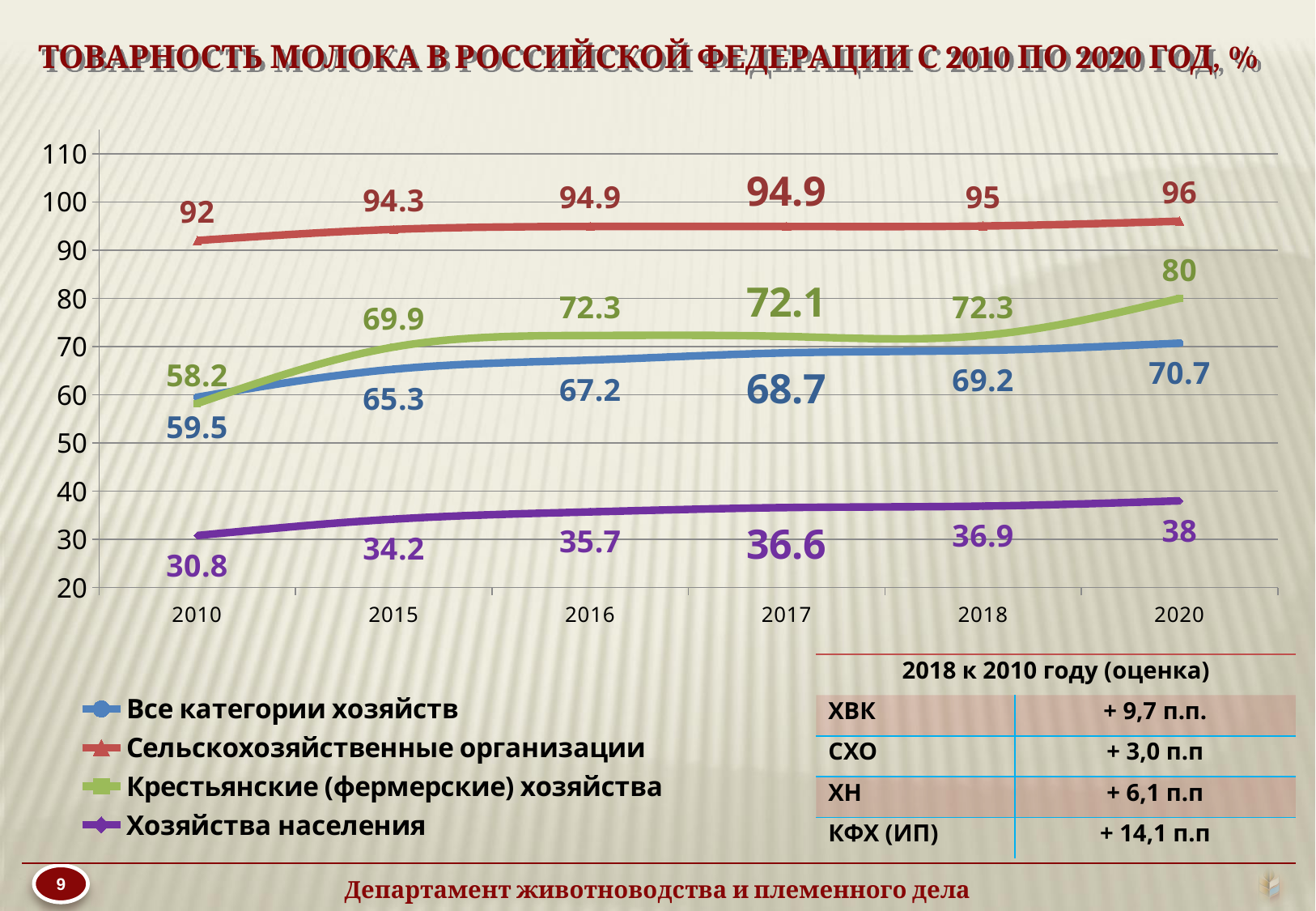
What is the value for Крестьянские (фермерские) хозяйства in 2015? 69.9 What type of chart is shown on the slide? line chart What is the difference between the 2020 and 2010 values for Крестьянские (фермерские) хозяйства? 21.8 How many years are shown on the x axis? 6 How many series does the legend list? 4 What is the value for Сельскохозяйственные организации in 2020? 96 Which series has the highest value in 2020? Сельскохозяйственные организации Which is larger in 2010: the value for Все категории хозяйств or the value for Крестьянские (фермерские) хозяйства? Все категории хозяйств Does the value for Хозяйства населения rise or fall from 2010 to 2020? rise What is the value for Все категории хозяйств in 2017? 68.7 What is the value for Хозяйства населения in 2010? 30.8 Which series has the lowest value in 2018? Хозяйства населения